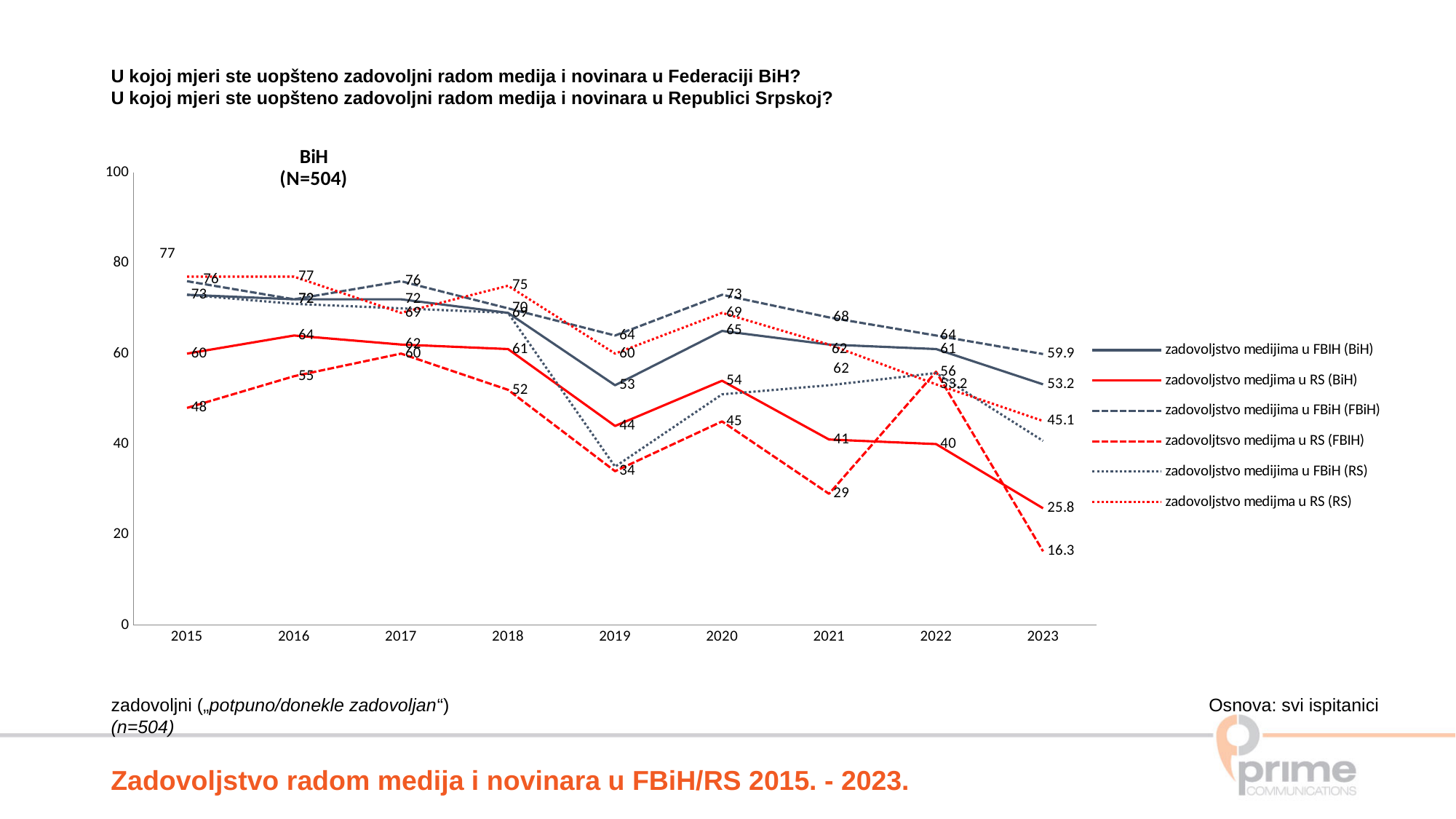
In 2023, which is larger: 'zadovoljstvo medijima u FBiH (FBiH)' or 'zadovoljstvo medijima u FBIH (BiH)'? zadovoljstvo medijima u FBiH (FBiH) What kind of chart is shown on the slide? line chart What is the value for 'zadovoljtsvo medijima u RS (FBIH)' in 2023? 16.3 What is the value for 'zadovoljstvo medijima u RS (BiH)' in 2023? 25.8 In which year is 'zadovoljtsvo medijima u RS (FBIH)' lowest? 2023 In which year is 'zadovoljstvo medijima u RS (BiH)' highest? 2016 What is the value for 'zadovoljstvo medijima u FBiH (FBiH)' in 2023? 59.9 How many years are shown on the x axis? 9 Is the 2023 value for 'zadovoljstvo medijima u FBiH (RS)' greater or less than 60? less What is the difference between the 2022 and 2023 values for 'zadovoljstvo medijima u RS (BiH)'? 14.2 What is the value for 'zadovoljstvo medijima u FBIH (BiH)' in 2019? 53 How many series does the legend list? 6